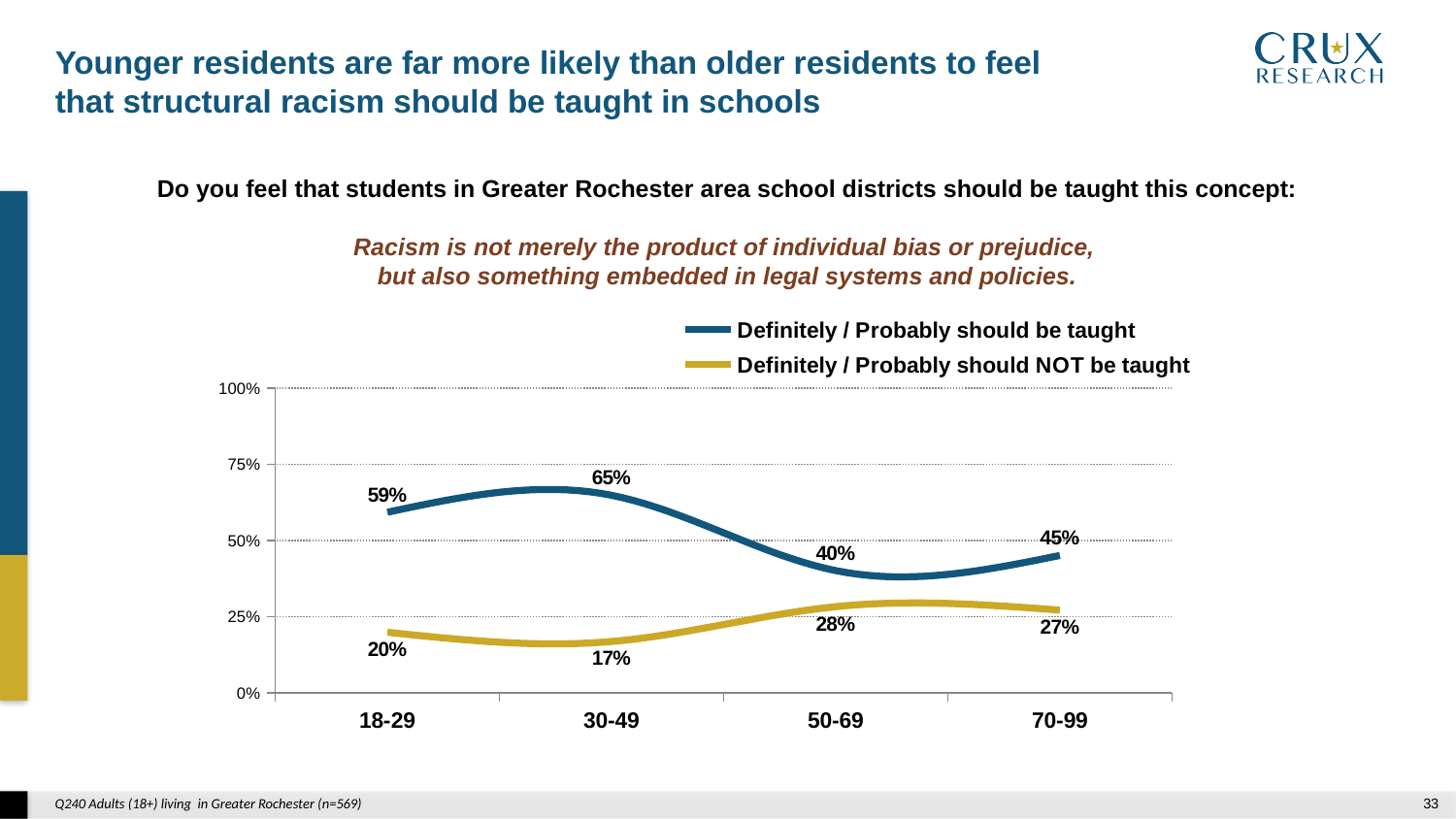
For the 70-99 age group, which is larger: 'should be taught' or 'should NOT be taught'? Definitely / Probably should be taught Which age group has the lowest value for 'Definitely / Probably should NOT be taught'? 30-49 What is the value for the 50-69 age group in the 'Definitely / Probably should NOT be taught' series? 28% Does the 'Definitely / Probably should be taught' line rise or fall from the 30-49 group to the 50-69 group? Fall How many age groups are shown on the x axis? 4 Which age group has the highest value for 'Definitely / Probably should be taught'? 30-49 What is the difference between the 'should be taught' and 'should NOT be taught' values for the 30-49 age group? 48% What colour is the line for 'Definitely / Probably should NOT be taught'? Gold/yellow What percentage of 18-29 year olds say the concept definitely or probably should be taught? 59% How many series does the legend list? 2 What kind of chart is shown on the slide? Line chart What is the value for the 70-99 age group in the 'Definitely / Probably should be taught' series? 45%